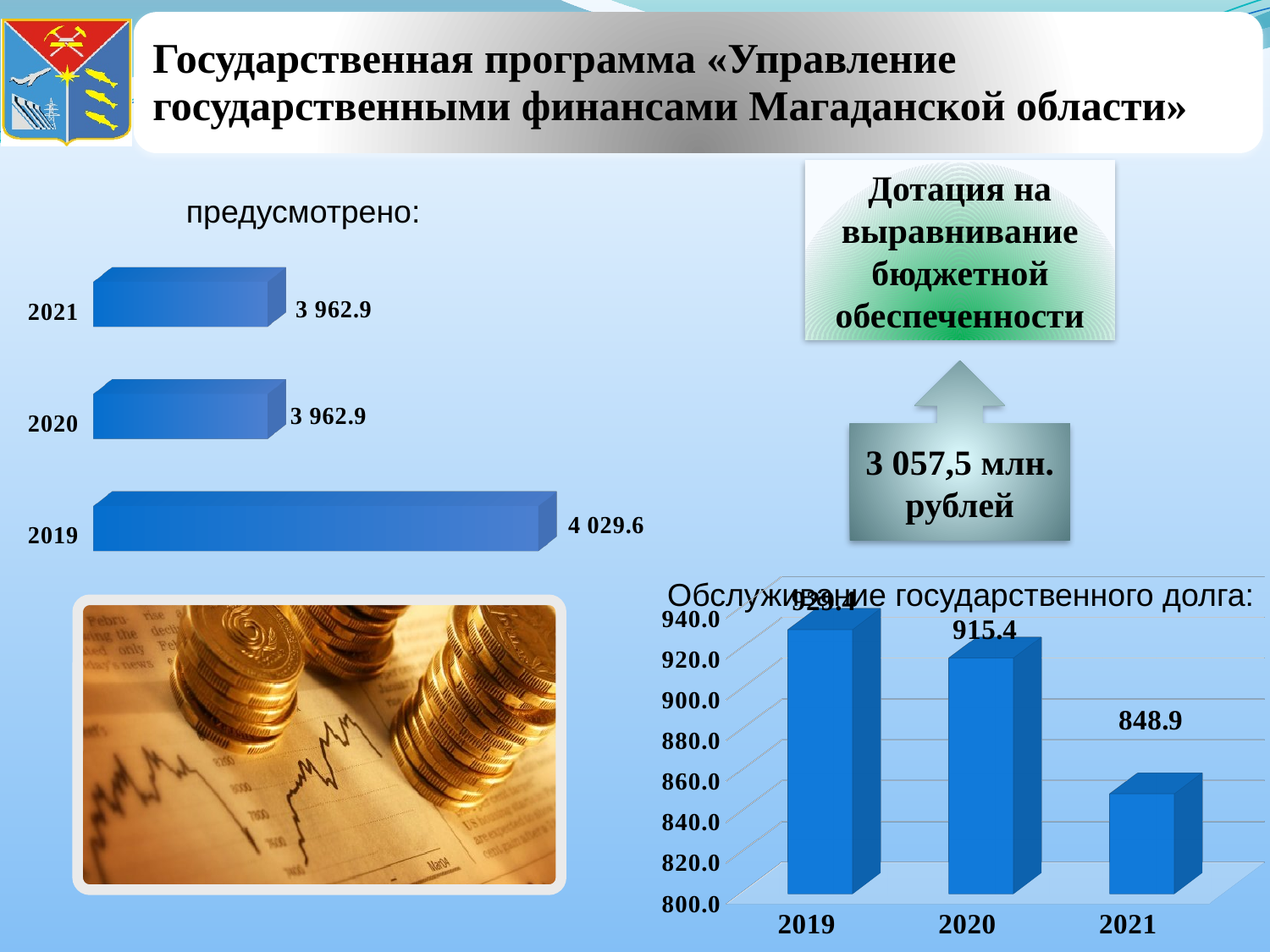
In the chart titled «предусмотрено:», what is the difference between the values for 2019 and 2021? 66.7 In the chart titled «предусмотрено:», how many bars are shown? 3 In the chart titled «Обслуживание государственного долга:», which year has the lowest value? 2021 In the chart titled «Обслуживание государственного долга:», is the value for 2019 greater or less than 920.0? greater In the chart titled «предусмотрено:», which year has the highest value? 2019 In the chart titled «Обслуживание государственного долга:», what is the value for 2020? 915.4 In the chart titled «предусмотрено:», what is the value for 2019? 4 029.6 What kind of chart is the one titled «предусмотрено:»? Bar chart In the chart titled «Обслуживание государственного долга:», what is the value for 2021? 848.9 In the chart titled «предусмотрено:», what is the value for 2020? 3 962.9 In the chart titled «Обслуживание государственного долга:», what is the difference between the values for 2020 and 2021? 66.5 In the chart titled «Обслуживание государственного долга:», do the values rise or fall from 2019 to 2021? Fall